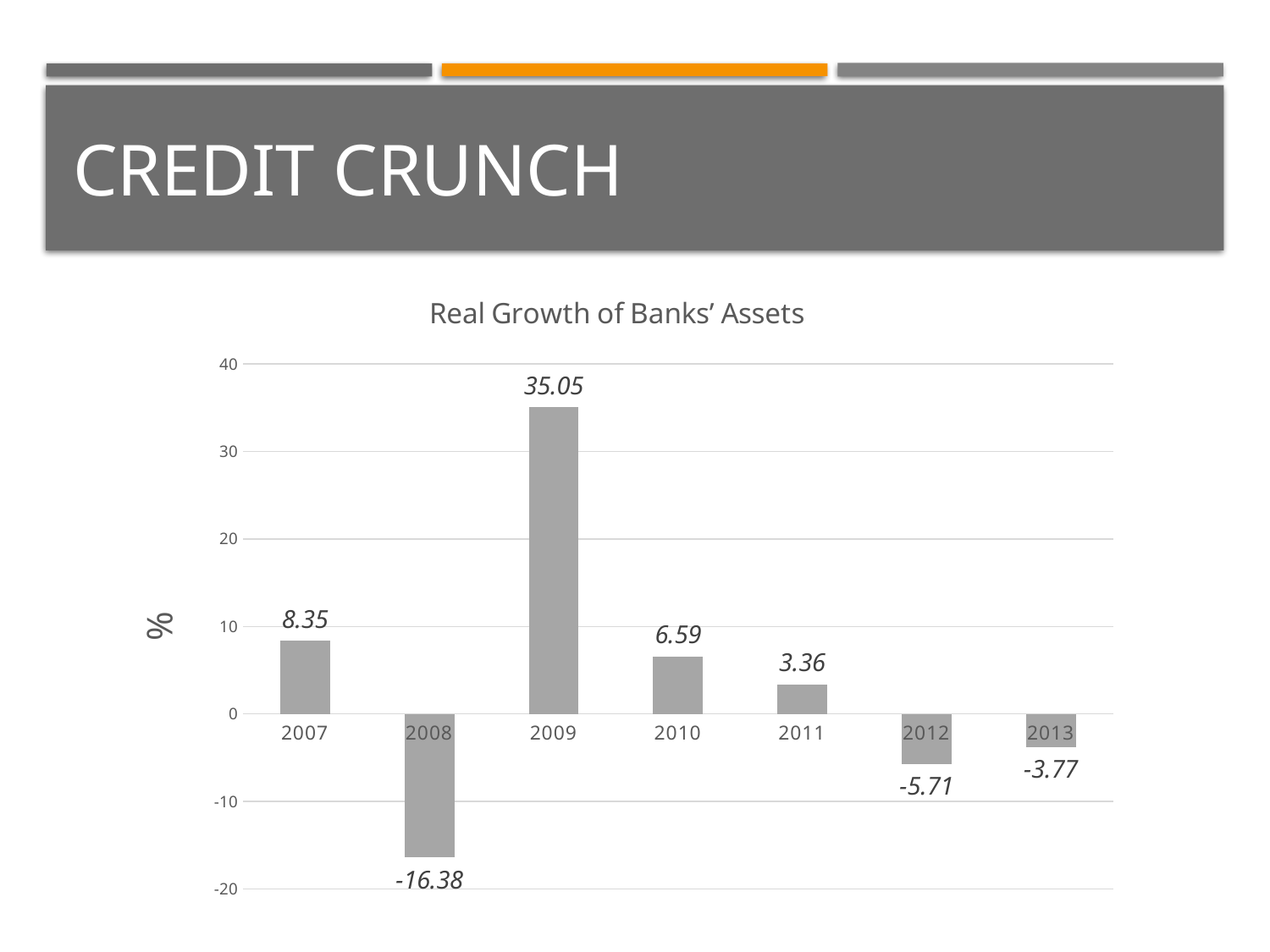
Which year has the lowest value in the Real Growth of Banks' Assets chart? 2008 Which year has the highest value in the Real Growth of Banks' Assets chart? 2009 How many years are shown in the Real Growth of Banks' Assets chart? 7 What is the value for 2008 in the Real Growth of Banks' Assets chart? -16.38 What is the value for 2013 in the Real Growth of Banks' Assets chart? -3.77 Is the value for 2009 in the Real Growth of Banks' Assets chart greater or less than 30? greater What is the title of the chart on the slide? Real Growth of Banks' Assets What kind of chart is the Real Growth of Banks' Assets chart? bar chart Which is larger in the Real Growth of Banks' Assets chart, the value for 2010 or the value for 2011? 2010 What is the difference between the values for 2007 and 2010 in the Real Growth of Banks' Assets chart? 1.76 Do the values in the Real Growth of Banks' Assets chart rise or fall from 2010 to 2013? fall What is the value for 2009 in the Real Growth of Banks' Assets chart? 35.05